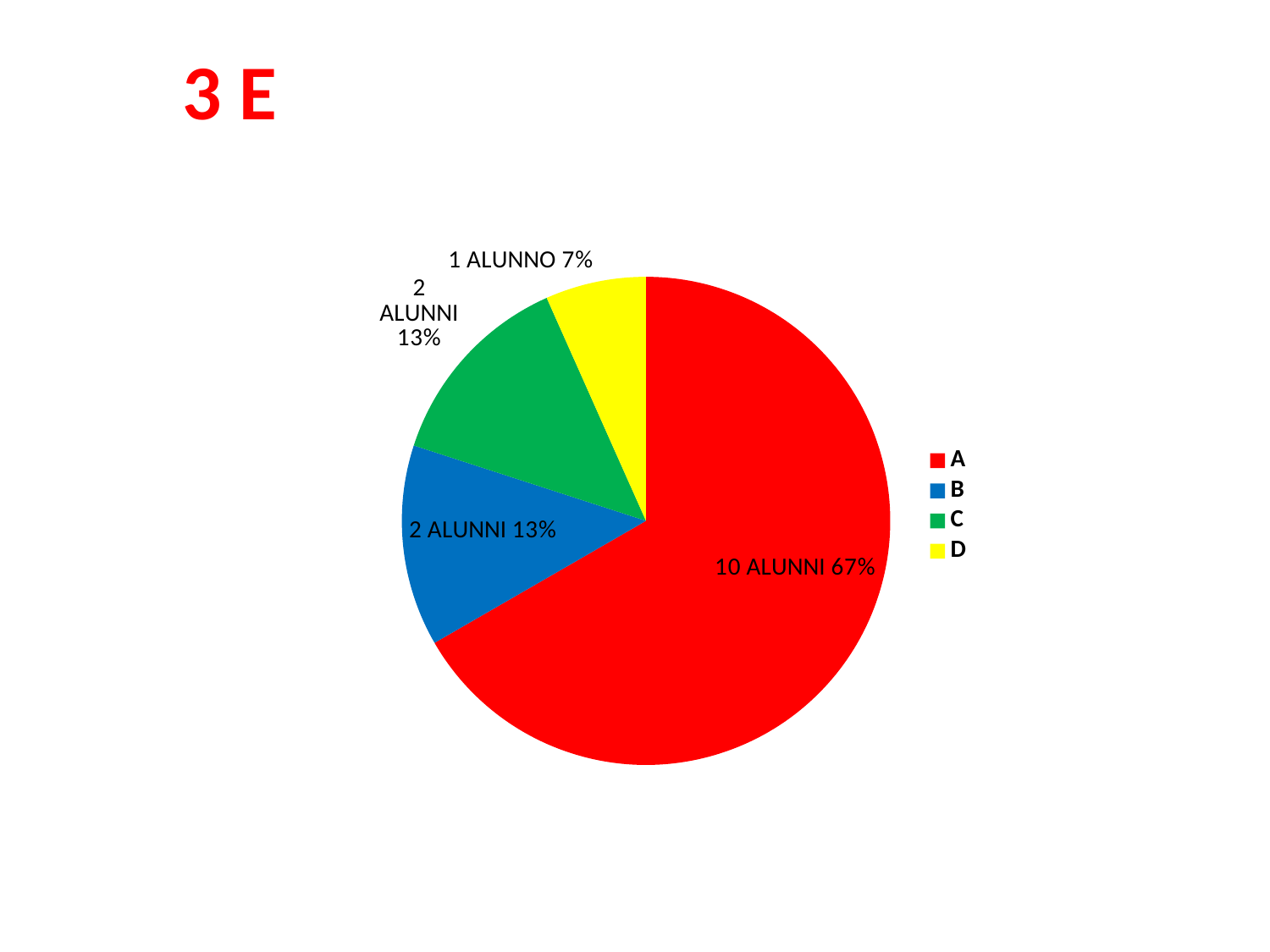
What is the difference in number of alunni between category A and category C? 8 Which category has the largest slice? A How many categories does the legend list? 4 What kind of chart is shown on the slide? pie chart How many alunni are in category A? 10 What percentage share does category D have? 7% How many alunni are in category B? 2 What percentage share does category A have? 67% What is the title shown on the slide? 3 E What colour is the slice for category C? green Which category has the smallest slice? D Which is larger, the slice for A or the slice for B? A